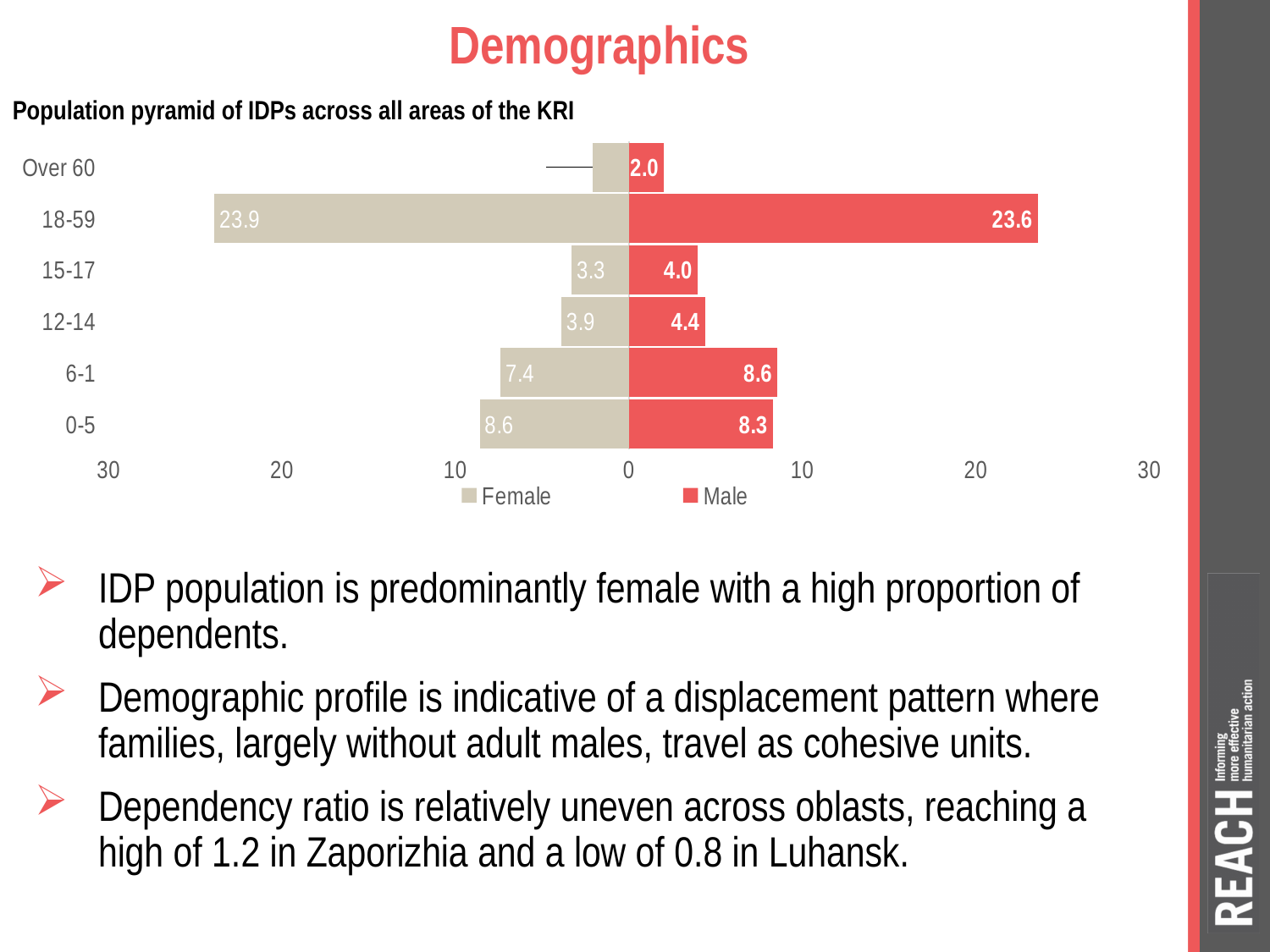
What are the two entries in the chart's legend? Female and Male For the 6-1 age group, which is larger, the Female value or the Male value? Male What is the Male value for the Over 60 age group? 2.0 Which age group has the highest Male value? 18-59 How many age groups are shown in the population pyramid? 6 Is the Female value for the 18-59 age group greater or less than 20? greater What kind of chart is shown on the slide? Bar chart What is the difference between the Female and Male values for the 18-59 age group? 0.3 What is the Female value for the 18-59 age group? 23.9 What is the Male value for the 0-5 age group? 8.3 Which age group has the lowest Male value? Over 60 How many series does the legend list? 2